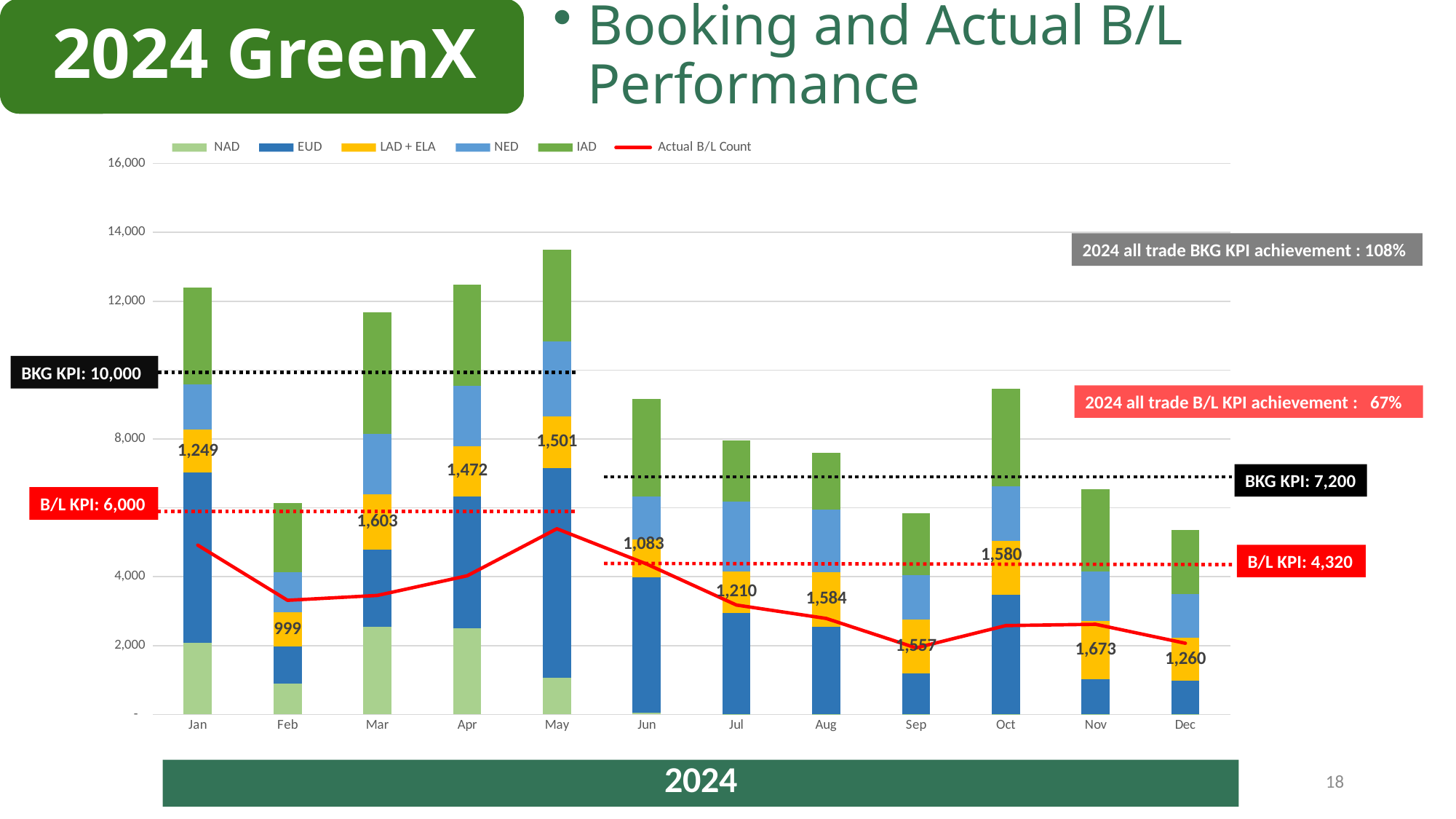
Is the Actual B/L Count for Dec greater or less than 4,000? less How many months are shown on the x axis? 12 Which month has the highest labelled LAD + ELA value? Nov Which month has the tallest stacked bar? May Does the Actual B/L Count line rise or fall from Jun to Sep? fall What is the data label shown on the LAD + ELA segment for Feb? 999 What is the data label shown on the LAD + ELA segment for Nov? 1,673 Which month has the lowest labelled LAD + ELA value? Feb How many series does the legend list? 6 Is the total stacked bar for May greater or less than 12,000? greater What is the difference between the labelled LAD + ELA values for Nov and Feb? 674 Which month has the larger labelled LAD + ELA value, Jul or Aug? Aug